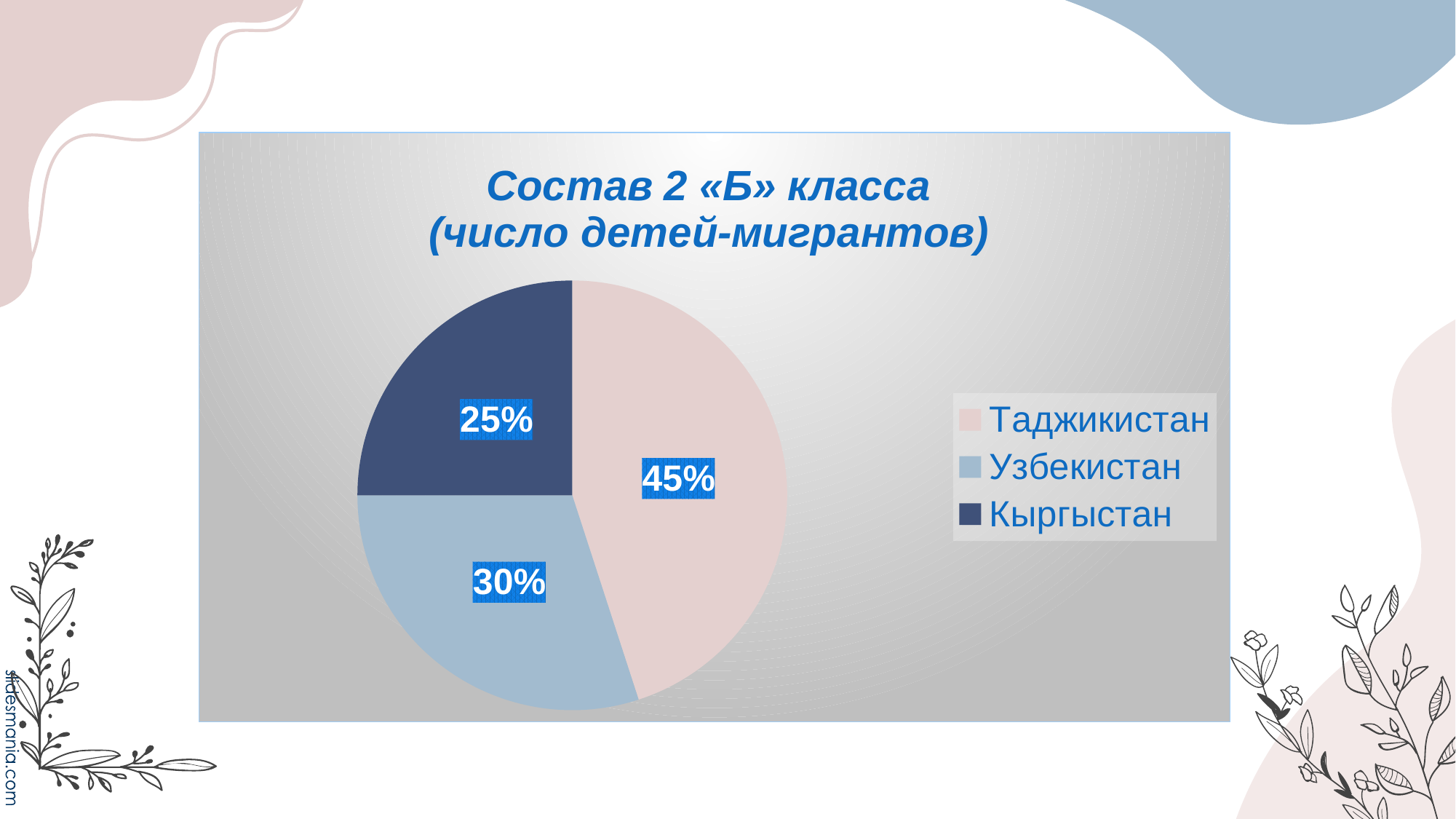
What is the difference between the shares of Таджикистан and Кыргыстан? 20% Which is larger, the share of Узбекистан or the share of Кыргыстан? Узбекистан What share of the pie does Таджикистан have? 45% What is the difference between the shares of Узбекистан and Кыргыстан? 5% Which category has the largest slice of the pie? Таджикистан What kind of chart is shown on the slide? pie chart Which category is shown in dark blue in the legend? Кыргыстан What share of the pie does Кыргыстан have? 25% What share of the pie does Узбекистан have? 30% How many categories does the pie chart have? 3 What is the title of the chart? Состав 2 «Б» класса (число детей-мигрантов) Which category has the smallest slice of the pie? Кыргыстан